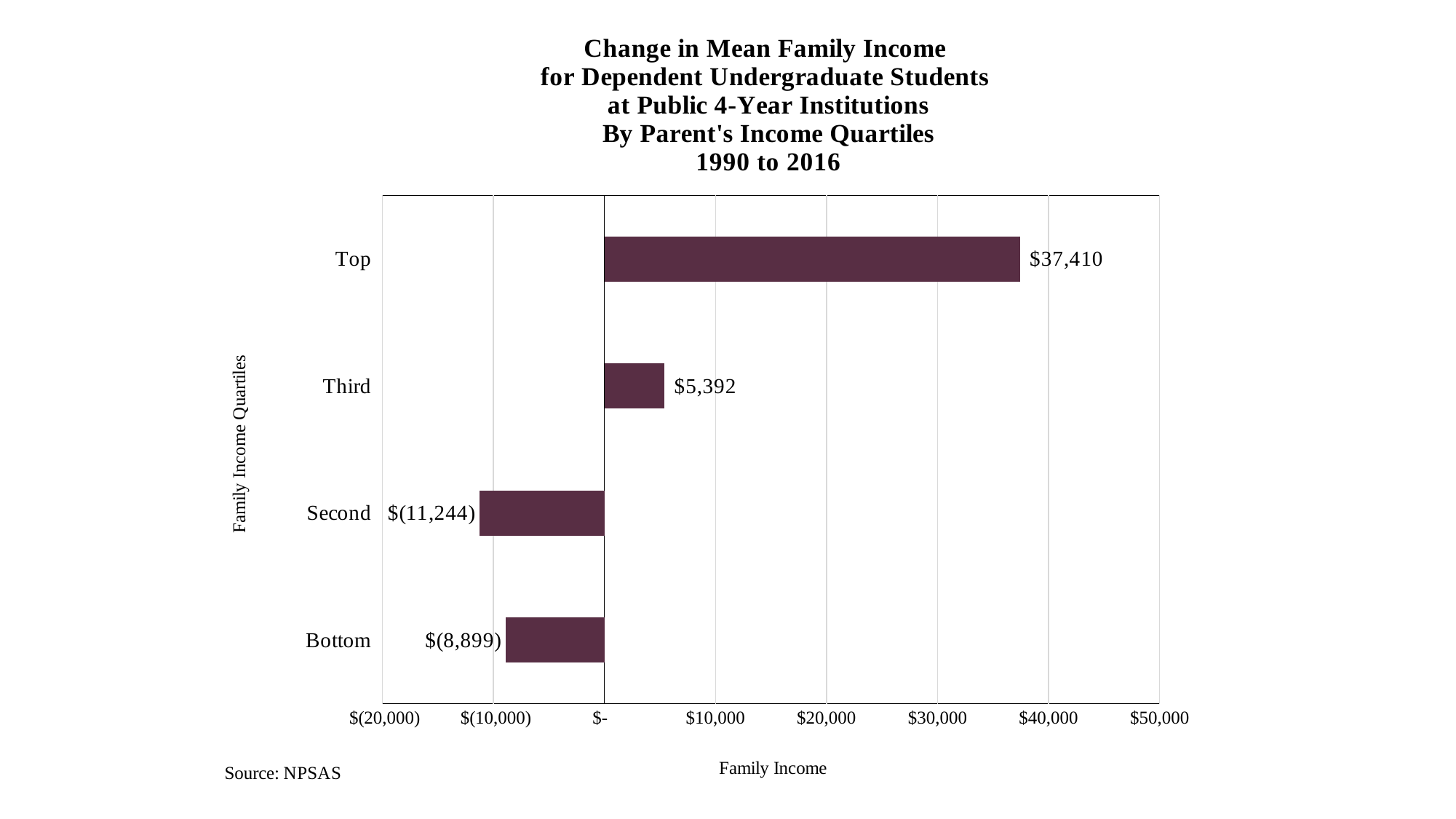
What is the difference between the change in mean family income for the Top quartile and the Third quartile? $32,018 Is the value for the Top quartile greater or less than $30,000? greater How many income quartiles are shown in the chart? 4 What is the change in mean family income for the Bottom quartile? $(8,899) What is the change in mean family income for the Third quartile? $5,392 What is the source cited for the chart data? NPSAS What is the change in mean family income for the Top quartile? $37,410 Which income quartile has the lowest change in mean family income? Second What is the change in mean family income for the Second quartile? $(11,244) What kind of chart is shown on the slide? Bar chart Which quartile has a larger change in mean family income, Third or Bottom? Third Which income quartile has the highest change in mean family income? Top